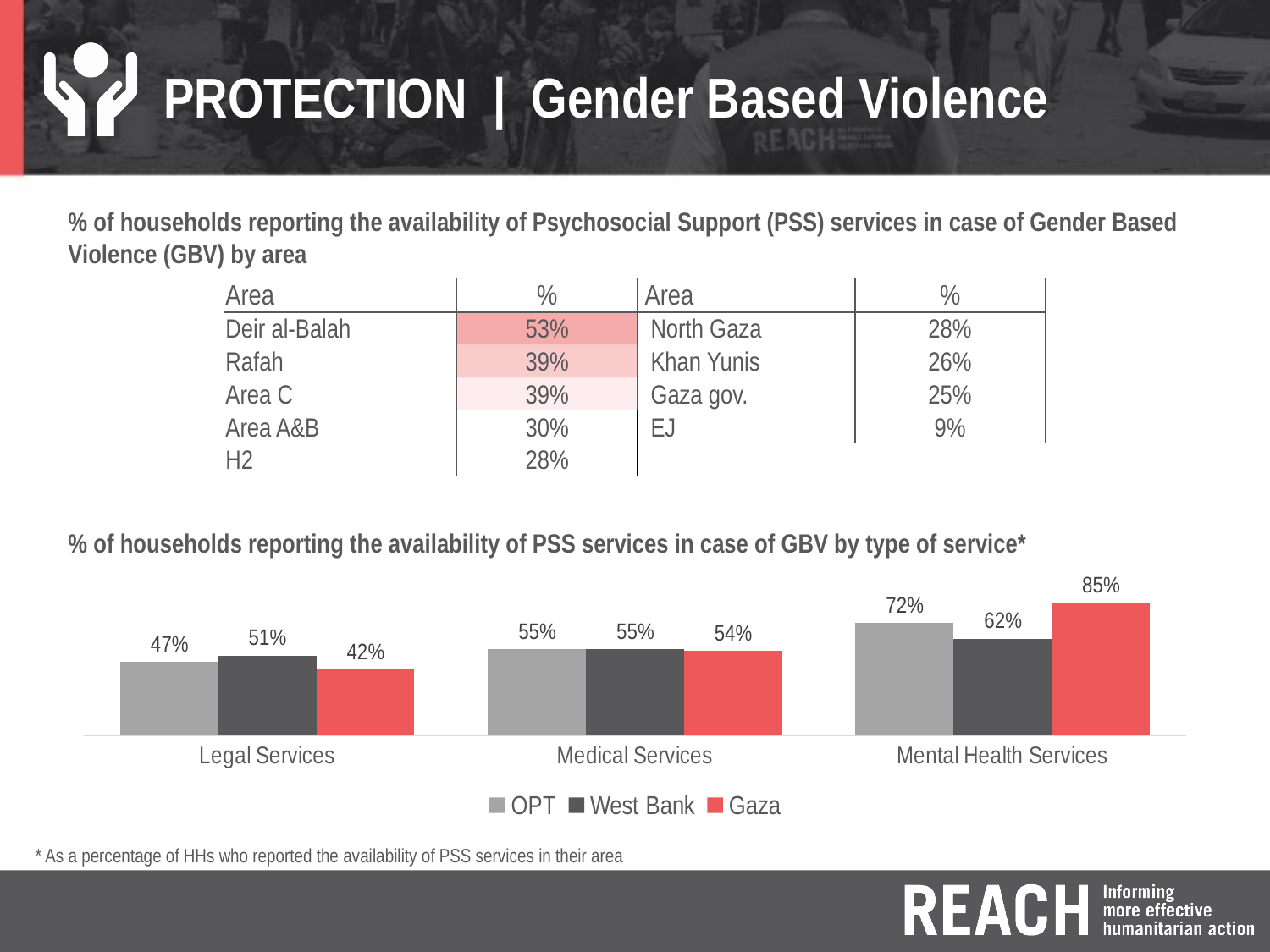
In the bar chart by type of service, what is the value for OPT for Legal Services? 47% In the bar chart by type of service, which type of service has the highest value for Gaza? Mental Health Services In the bar chart by type of service, what is the value for Gaza for Mental Health Services? 85% What kind of chart is used to show PSS service availability by type of service? Bar chart In the bar chart by type of service, what is the value for West Bank for Medical Services? 55% In the bar chart by type of service, what is the difference between the Gaza and West Bank values for Mental Health Services? 23% In the bar chart by type of service, do the OPT values rise or fall from Legal Services to Mental Health Services? Rise In the bar chart by type of service, how many types of service are shown on the x axis? 3 In the bar chart by type of service, which series is shown in red? Gaza In the bar chart by type of service, which is larger for Legal Services: the West Bank value or the Gaza value? West Bank In the bar chart by type of service, how many series does the legend list? 3 In the bar chart by type of service, which type of service has the lowest value for West Bank? Legal Services